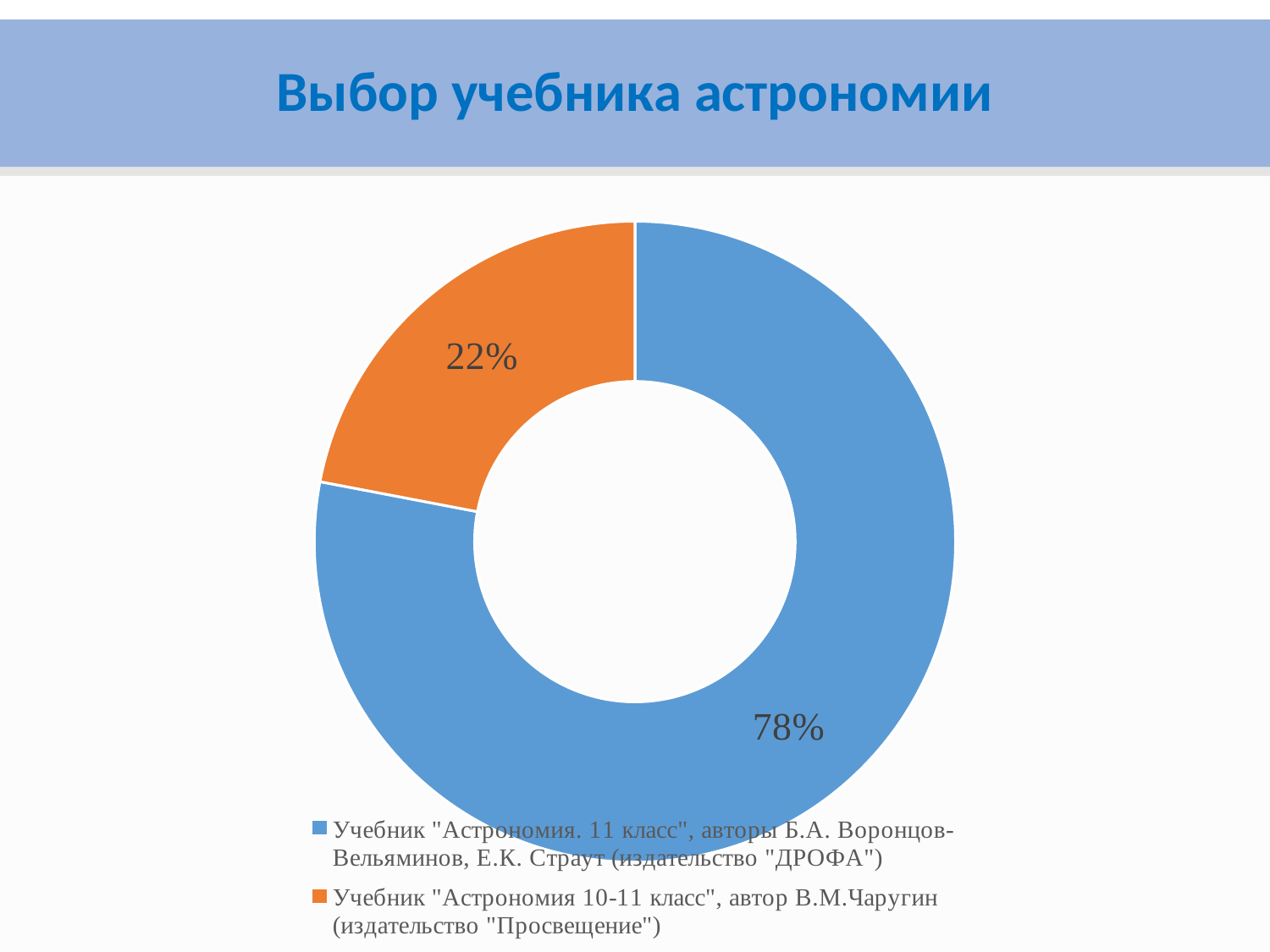
How many entries does the legend list? 2 How many categories are shown in the chart? 2 What is the title of the slide? Выбор учебника астрономии What share of the chart does the textbook "Астрономия 10-11 класс" by В.М.Чаругин (издательство "Просвещение") have? 22% Which textbook has the largest share in the chart? Учебник "Астрономия. 11 класс", авторы Б.А. Воронцов-Вельяминов, Е.К. Страут (издательство "ДРОФА") What is the total of the two shares shown in the chart? 100% What is the difference in percentage points between the share of the Воронцов-Вельяминов/Страут textbook and the Чаругин textbook? 56 Which textbook has the smallest share in the chart? Учебник "Астрономия 10-11 класс", автор В.М.Чаругин (издательство "Просвещение") What colour represents the textbook by В.М.Чаругин (издательство "Просвещение")? Orange What share of the chart does the textbook "Астрономия. 11 класс" by Воронцов-Вельяминов and Страут (издательство "ДРОФА") have? 78% Which has a larger share: the textbook published by "ДРОФА" or the textbook published by "Просвещение"? Учебник published by "ДРОФА" What kind of chart is shown on the slide? Doughnut (pie) chart